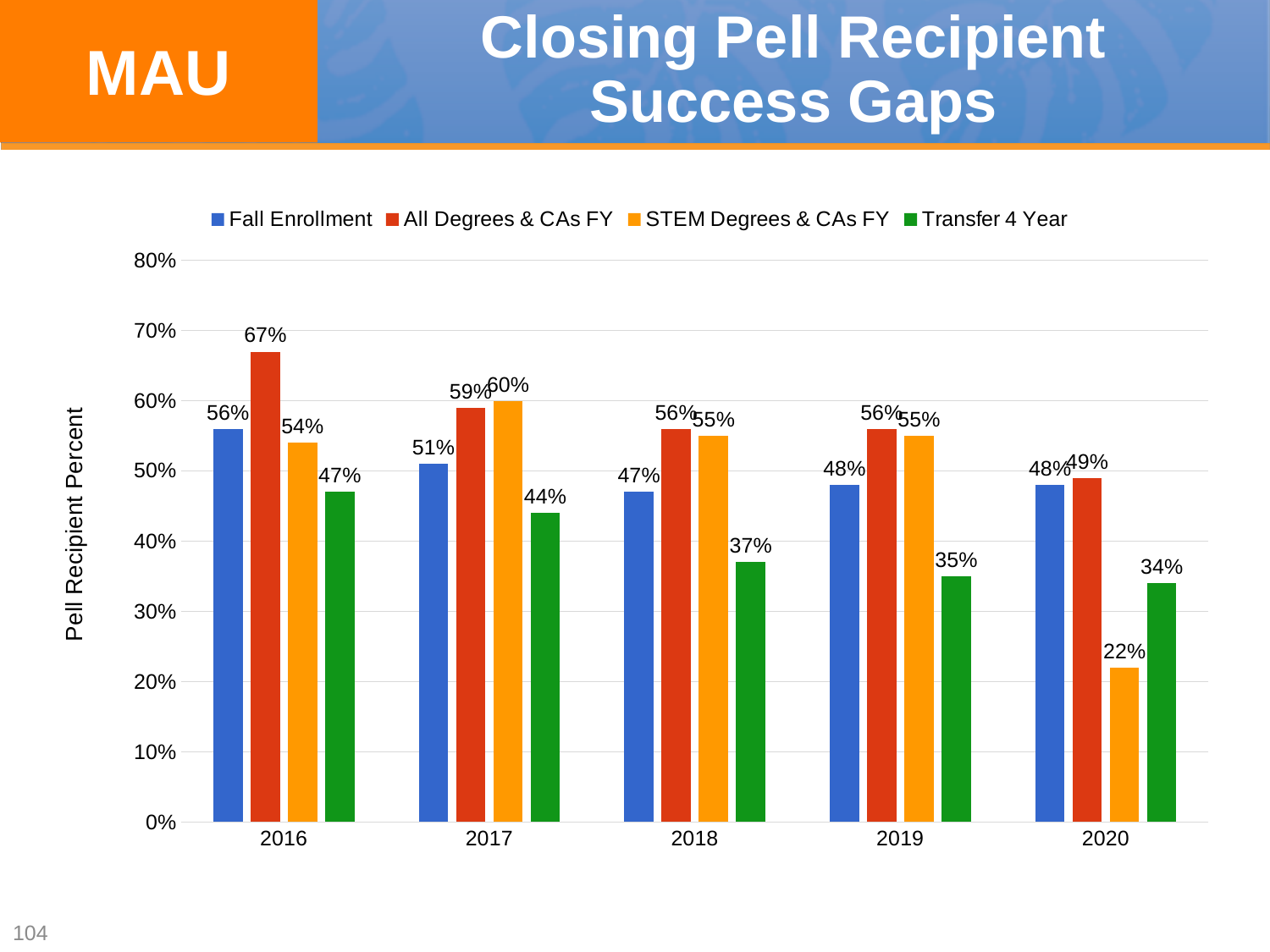
How many years are shown on the x axis? 5 In which year is the Transfer 4 Year value lowest? 2020 Is the Transfer 4 Year value for 2019 greater or less than 40%? less What is the Transfer 4 Year value for 2018? 37% In which year is the All Degrees & CAs FY value highest? 2016 What is the label on the vertical axis? Pell Recipient Percent What is the difference between the All Degrees & CAs FY value and the Transfer 4 Year value in 2016? 20% What is the STEM Degrees & CAs FY value for 2020? 22% What is the Fall Enrollment value for 2016? 56% How many series does the legend list? 4 What kind of chart is shown on the slide? bar chart Which is larger in 2017: the STEM Degrees & CAs FY value or the Fall Enrollment value? STEM Degrees & CAs FY